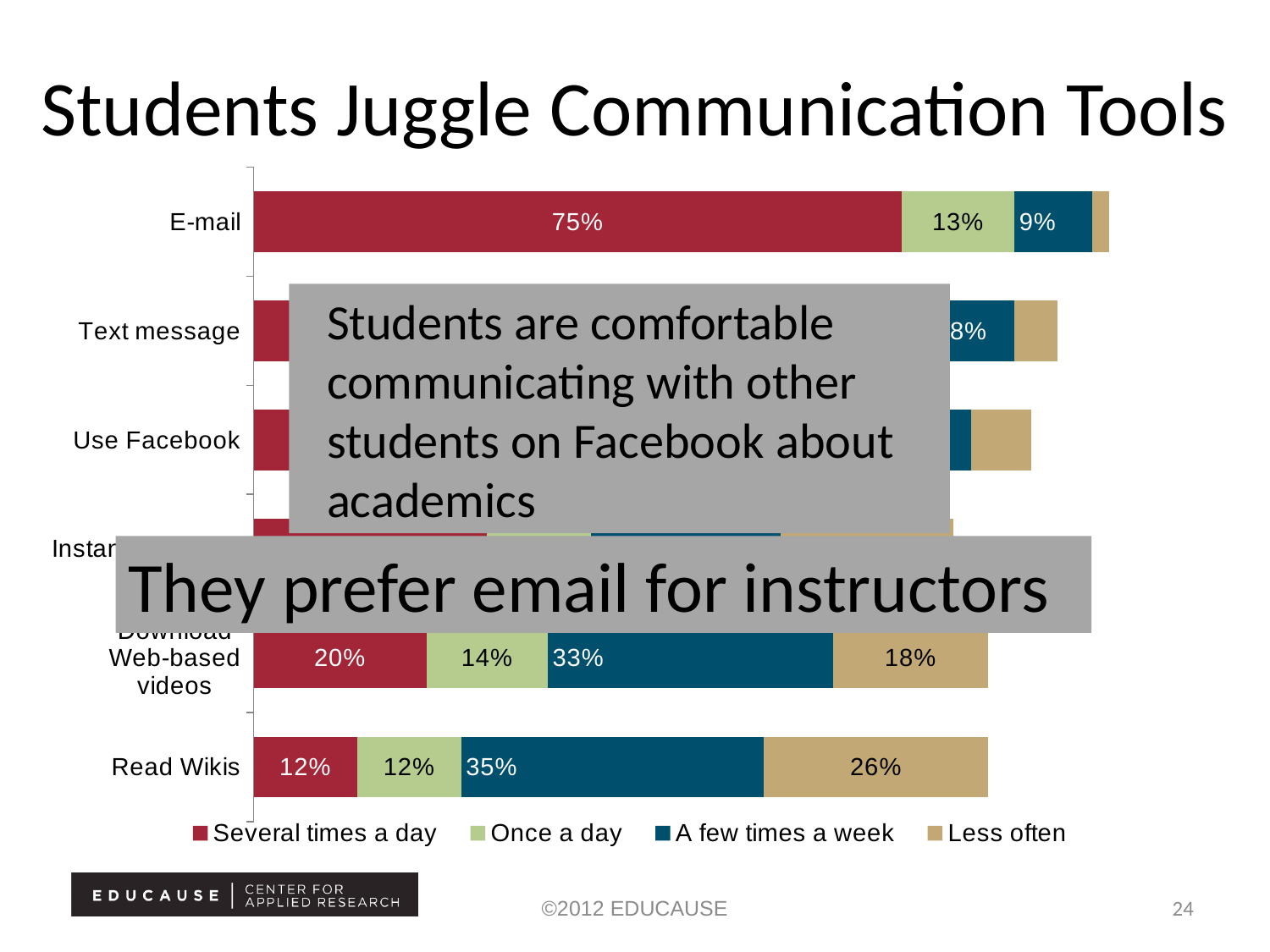
What is the 'A few times a week' value for E-mail? 9% What is the 'Once a day' value for E-mail? 13% What is the total of the labelled segments in the Read Wikis bar? 85% What is the 'Several times a day' value for Read Wikis? 12% Which has the larger 'Less often' value: Read Wikis or Download Web-based videos? Read Wikis How much larger is the 'Several times a day' value for Download Web-based videos than for Read Wikis? 8 percentage points What percentage of students use E-mail several times a day? 75% What kind of chart is shown on the slide? Stacked bar chart How many series does the legend list? 4 What is the 'Less often' value for Read Wikis? 26% What is the 'A few times a week' value for Download Web-based videos? 33%